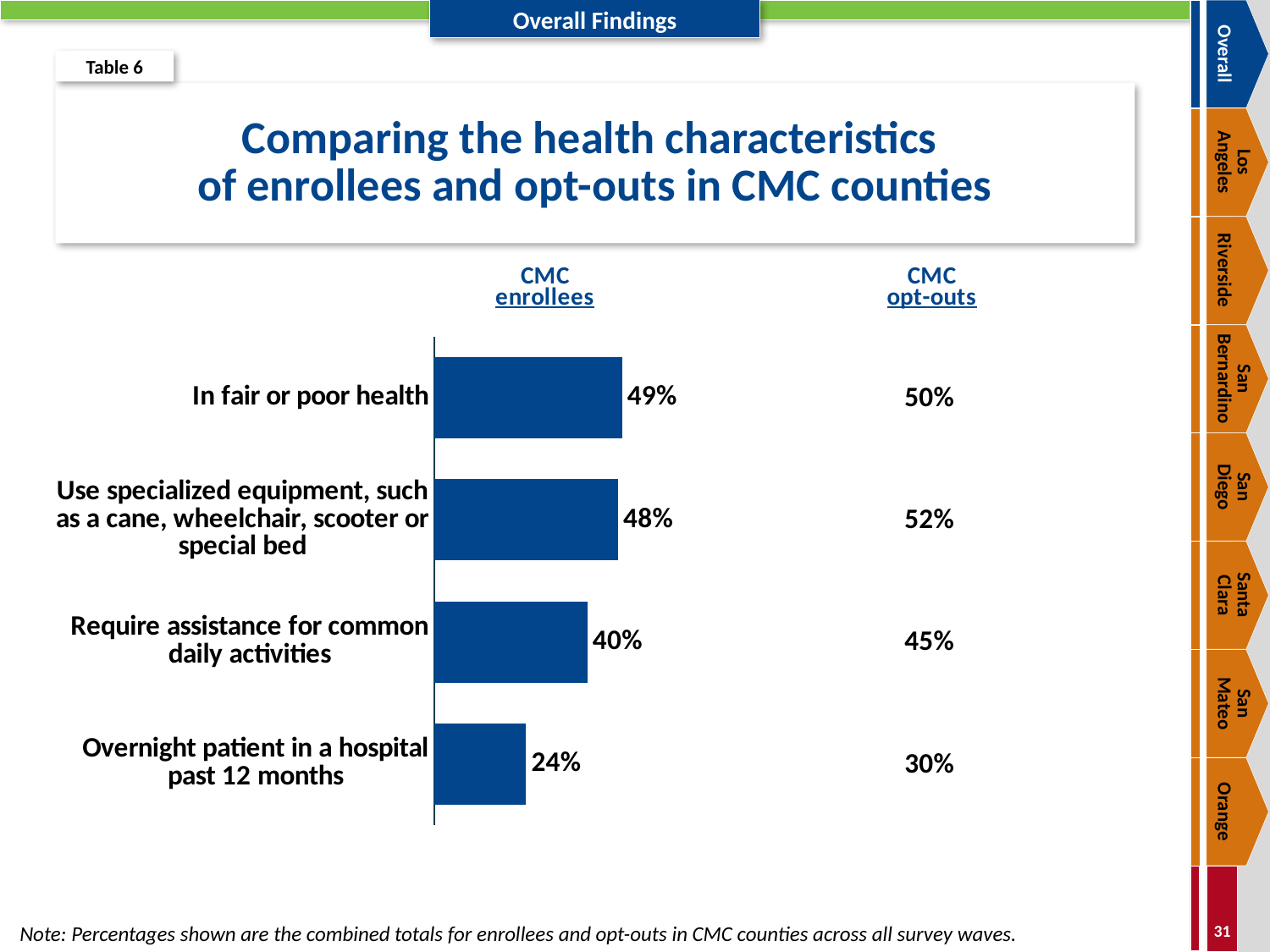
What percentage of CMC enrollees were an overnight patient in a hospital in the past 12 months? 24% Which health characteristic has the highest percentage among CMC enrollees? In fair or poor health What percentage of CMC enrollees require assistance for common daily activities? 40% Which health characteristic has the lowest percentage among CMC enrollees? Overnight patient in a hospital past 12 months What percentage of CMC enrollees use specialized equipment, such as a cane, wheelchair, scooter or special bed? 48% What percentage of CMC opt-outs require assistance for common daily activities? 45% What is the difference in percentage points between CMC opt-outs and CMC enrollees who were an overnight patient in a hospital in the past 12 months? 6 What type of chart is used to show the CMC enrollee percentages? Bar chart Among CMC enrollees, which is larger: the percentage requiring assistance for common daily activities or the percentage who were an overnight patient in a hospital in the past 12 months? Require assistance for common daily activities How many health characteristics are shown as bars in the chart? 4 What percentage of CMC enrollees are in fair or poor health? 49% What is the difference in percentage points between CMC enrollees in fair or poor health and those who were an overnight patient in a hospital in the past 12 months? 25